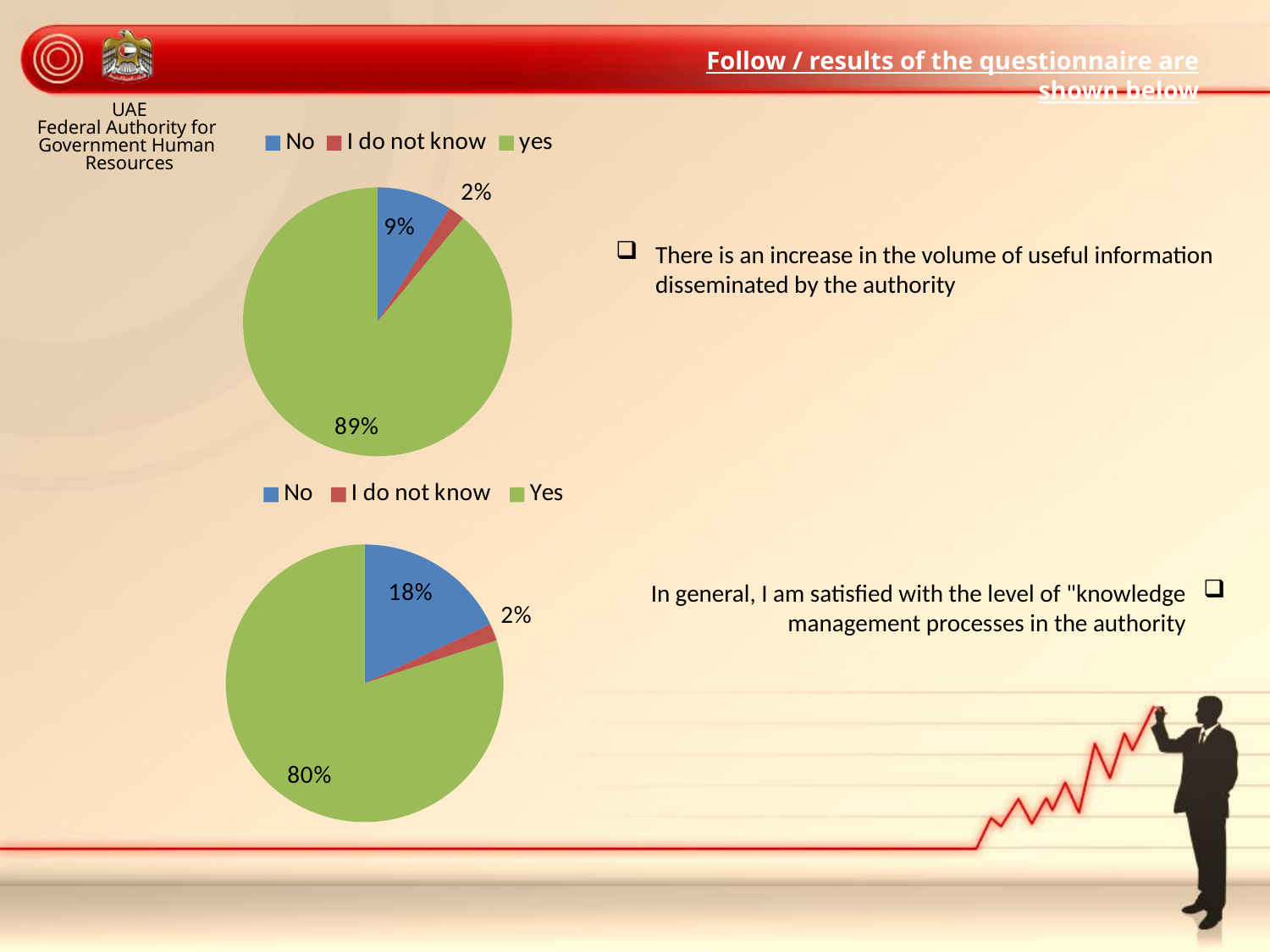
In the bottom pie chart, what percentage of respondents answered "Yes"? 80% In the top pie chart, what colour represents the "No" response? Blue In the bottom pie chart, what percentage of respondents answered "No"? 18% What type of chart is the bottom chart on the slide? Pie chart Which is larger: the "No" share in the top pie chart or the "No" share in the bottom pie chart? The bottom pie chart How many categories does the legend of the top pie chart list? 3 In the top pie chart, what percentage of respondents answered "I do not know"? 2% In the top pie chart, what percentage of respondents answered "No"? 9% In the bottom pie chart, which response has the largest share? Yes In the top pie chart, which response has the smallest share? I do not know In the bottom pie chart, what is the difference between the "Yes" share and the "No" share? 62% In the top pie chart, what percentage of respondents answered "yes"? 89%